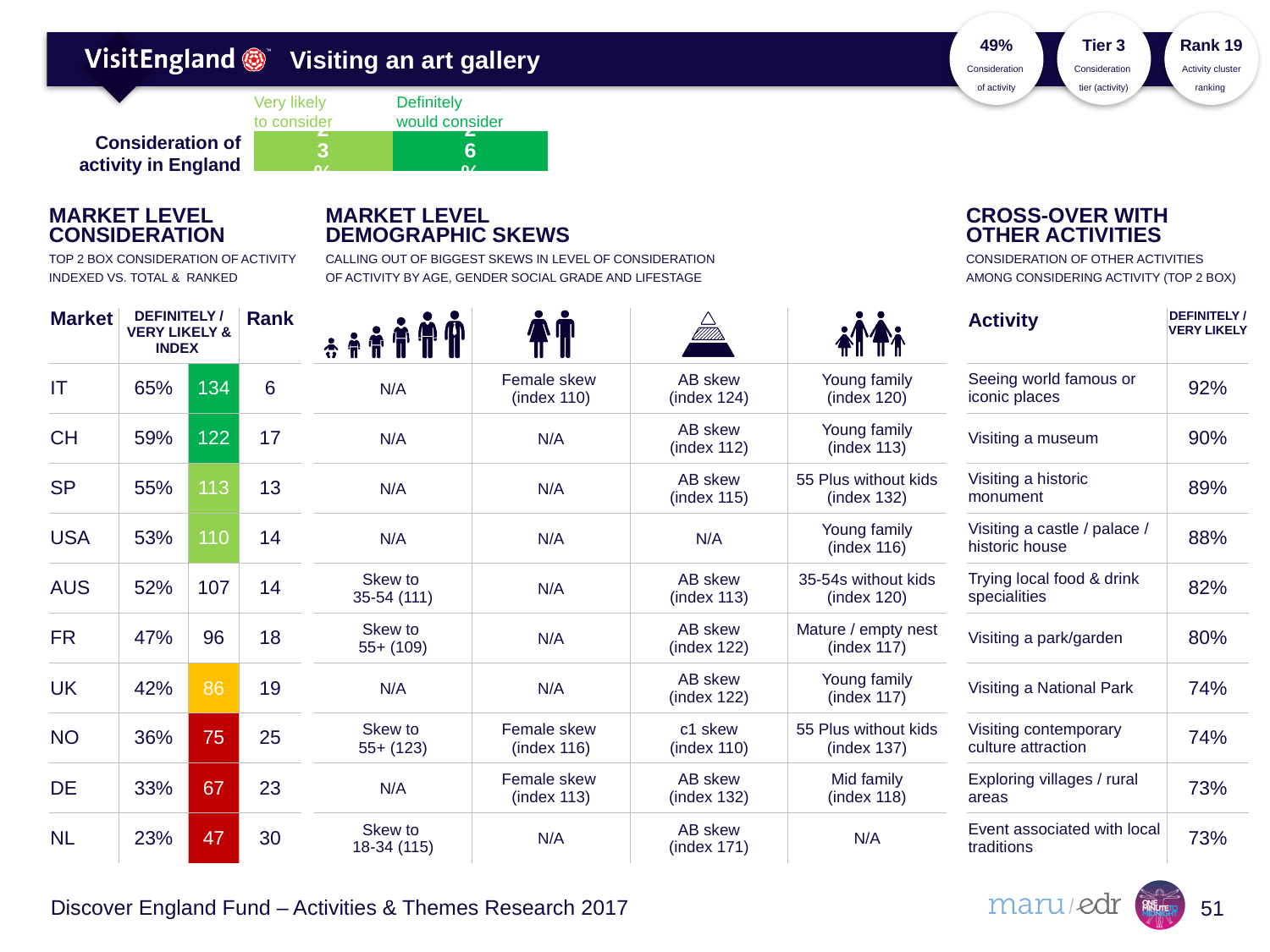
In the 'Consideration of activity in England' chart, which colour is used for the 'Definitely would consider' segment? dark green What kind of chart is the 'Consideration of activity in England' chart? bar chart How many series does the 'Consideration of activity in England' chart show? 2 What are the two series names shown above the 'Consideration of activity in England' bar? Very likely to consider; Definitely would consider In the 'Consideration of activity in England' chart, what is the value for 'Very likely to consider'? 23% In the 'Consideration of activity in England' chart, which segment is larger: 'Very likely to consider' or 'Definitely would consider'? Definitely would consider In the 'Consideration of activity in England' chart, what is the total of the two segments of the stacked bar? 49% In the 'Consideration of activity in England' chart, what is the value for 'Definitely would consider'? 26% In the 'Consideration of activity in England' chart, what is the difference between 'Definitely would consider' and 'Very likely to consider'? 3%